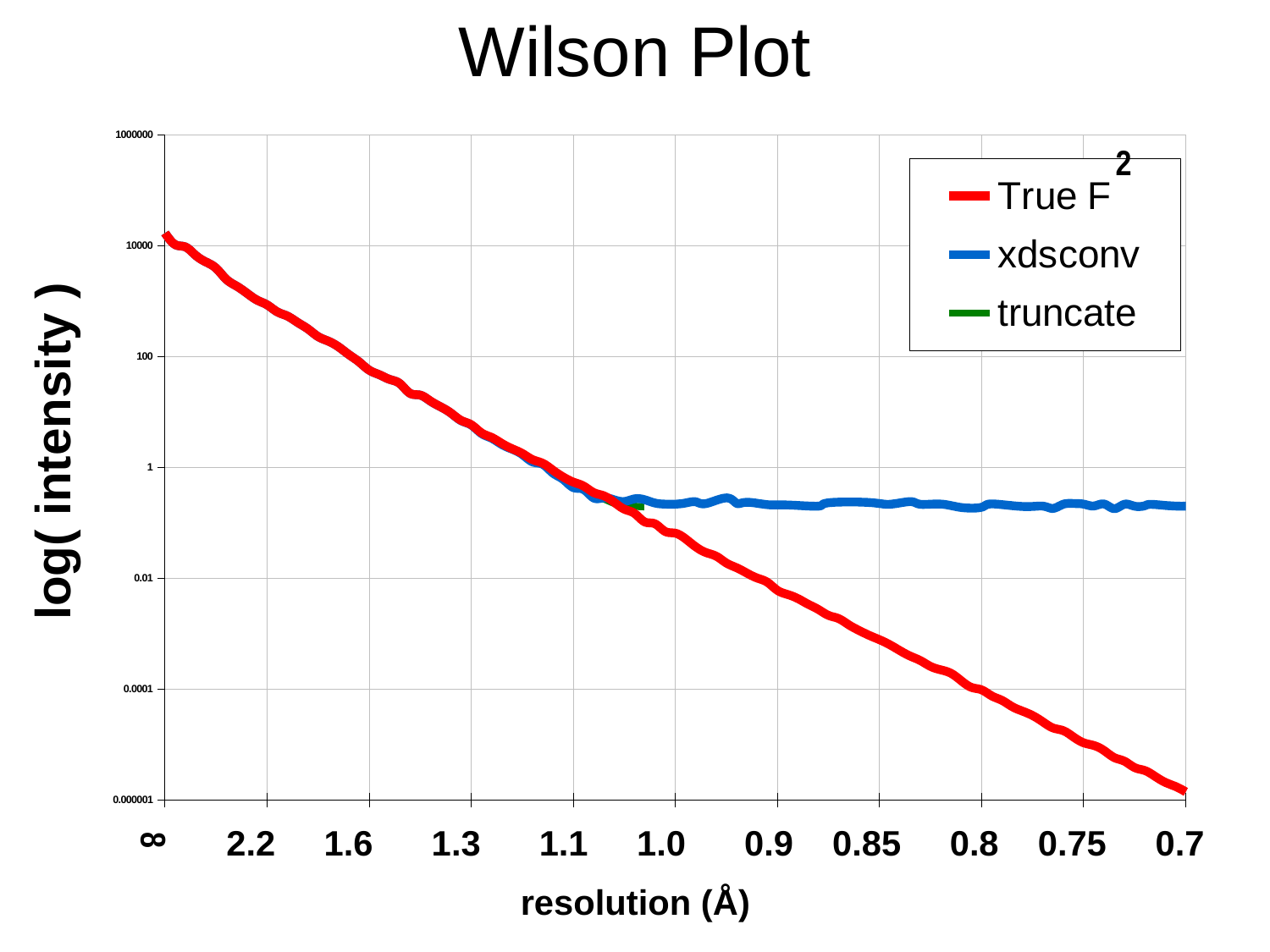
Is the value of True F² at the ∞ end of the x axis greater or less than 100? greater How many tick labels are shown on the x axis? 11 At a resolution of 0.7 Å, which series has the larger value, xdsconv or True F²? xdsconv At a resolution of 0.8 Å, which series has the larger value, True F² or xdsconv? xdsconv What is the title of the chart? Wilson Plot What kind of chart is the Wilson Plot? line chart What is the label of the x axis? resolution (Å) Is the value of True F² at 0.85 Å greater or less than 0.01? less How many series does the legend of the Wilson Plot list? 3 Does the True F² series rise or fall from left to right along the x axis? fall Is the value of xdsconv at 0.7 Å greater or less than 0.01? greater